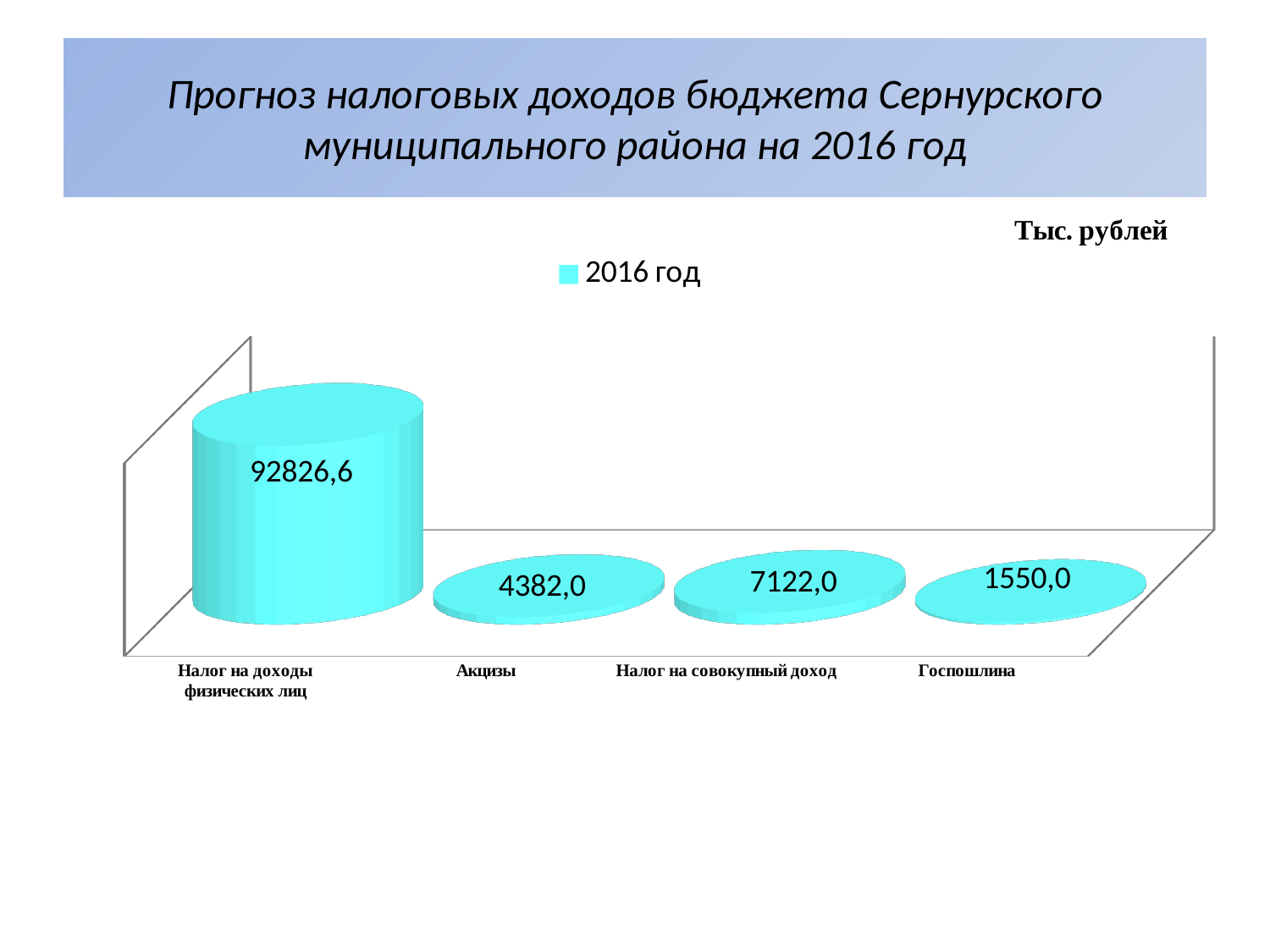
Which category has the highest value? Налог на доходы физических лиц What is the value for Налог на совокупный доход? 7122,0 What is the difference between the values for Акцизы and Госпошлина? 2832,0 What is the value for Акцизы? 4382,0 How many categories are shown in the chart? 4 How many series does the legend list? 1 What is the value for Налог на доходы физических лиц? 92826,6 Which category has the lowest value? Госпошлина What kind of chart is shown on the slide? bar chart Which is larger, the value for Акцизы or the value for Налог на совокупный доход? Налог на совокупный доход What is the value for Госпошлина? 1550,0 What is the difference between the values for Налог на совокупный доход and Акцизы? 2740,0